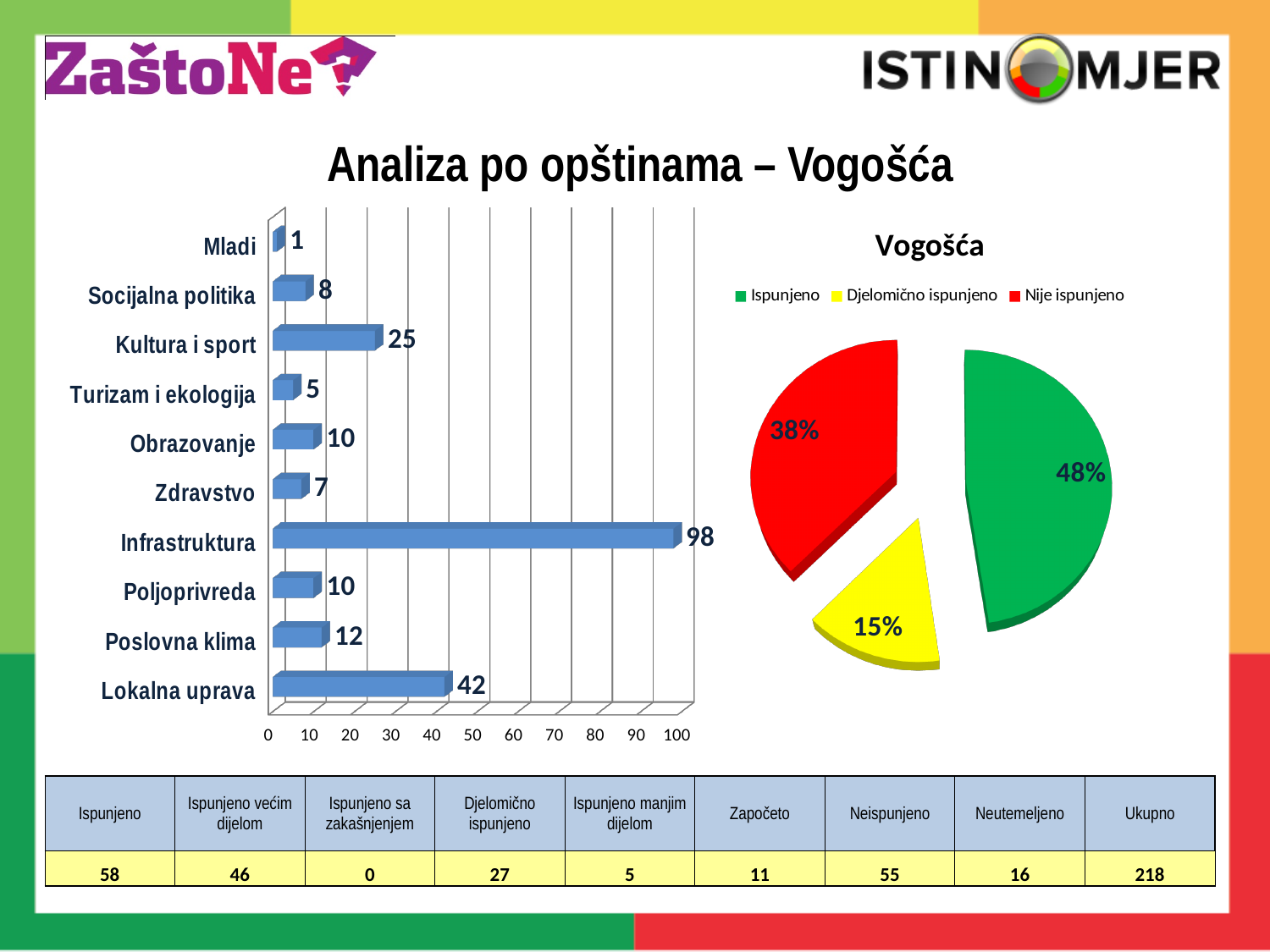
In the pie chart titled Vogošća, what share does Ispunjeno have? 48% In the bar chart on the left, what is the difference between the values for Infrastruktura and Lokalna uprava? 56 In the bar chart on the left, what is the value for Infrastruktura? 98 In the bar chart on the left, which is larger, the value for Poslovna klima or the value for Socijalna politika? Poslovna klima In the bar chart on the left, what is the value for Kultura i sport? 25 How many entries does the legend of the pie chart titled Vogošća list? 3 How many categories are shown in the bar chart on the left? 10 In the bar chart on the left, which category has the highest value? Infrastruktura What kind of chart is the chart on the left of the slide? Bar chart In the pie chart titled Vogošća, what share does Djelomično ispunjeno have? 15% In the bar chart on the left, what is the value for Lokalna uprava? 42 In the bar chart on the left, which category has the lowest value? Mladi